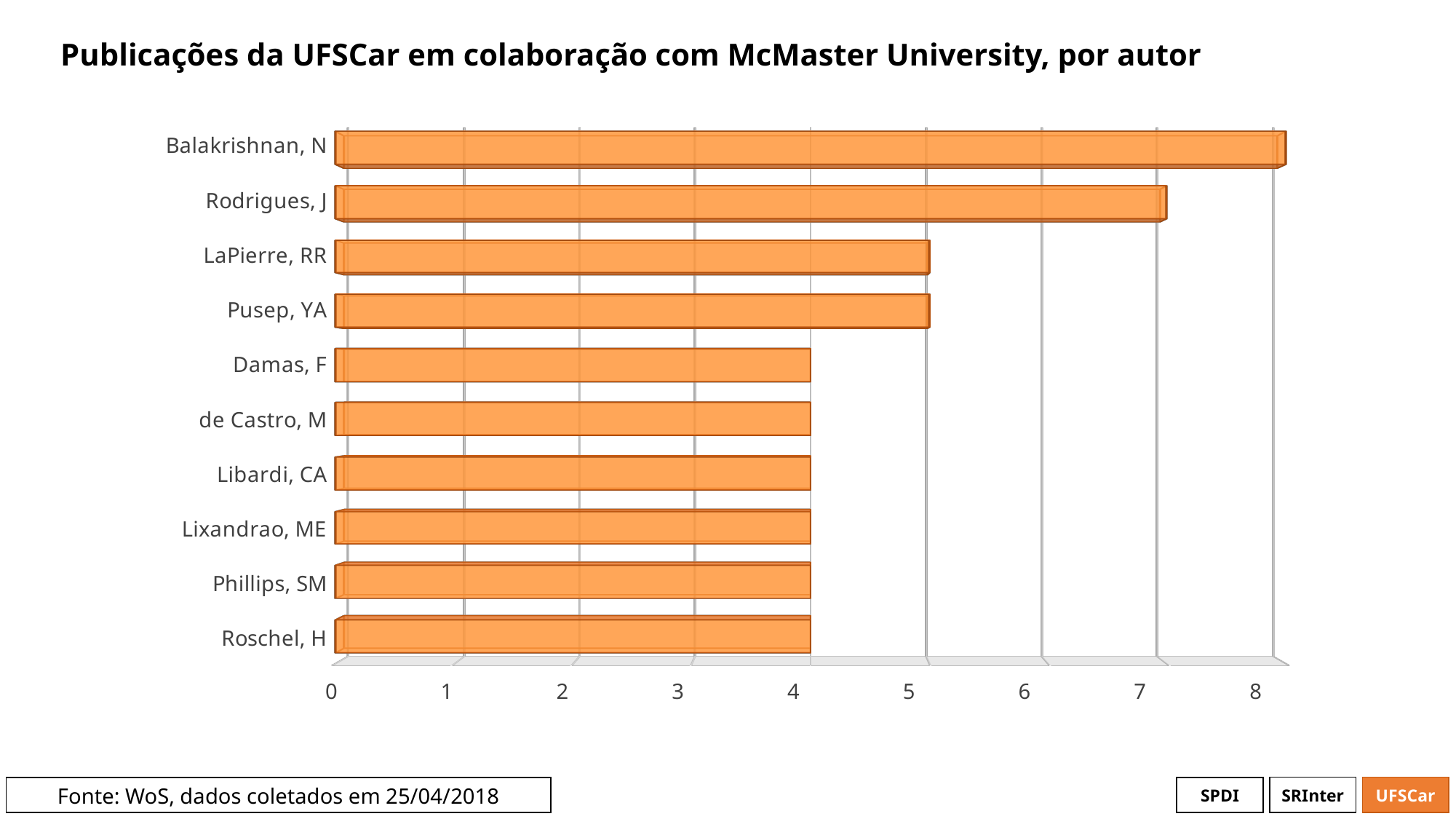
How many authors are listed in the chart? 10 Is the value for Damas, F greater or less than 5? less What kind of chart is shown on the slide? bar chart Which is larger, the value for LaPierre, RR or the value for Libardi, CA? LaPierre, RR What is the title of the chart? Publicações da UFSCar em colaboração com McMaster University, por autor Which is larger, the value for Rodrigues, J or the value for Pusep, YA? Rodrigues, J Is the value for Balakrishnan, N greater or less than 7? greater Is the value for Roschel, H greater or less than 3? greater Which author has the second-longest bar in the chart? Rodrigues, J Which author has the highest number of publications in the chart? Balakrishnan, N